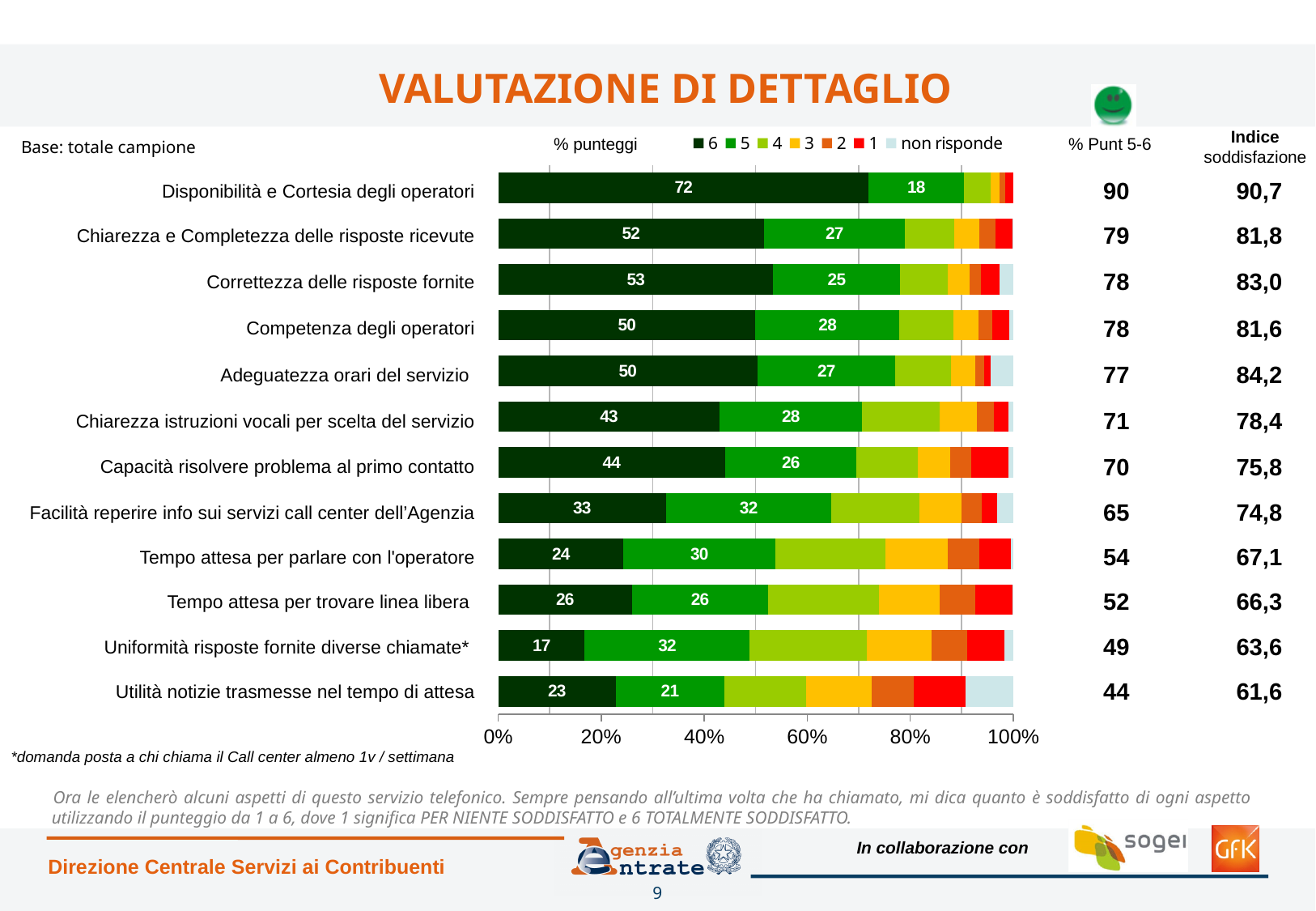
Which category has the lowest value for the "6" series? Uniformità risposte fornite diverse chiamate* Which legend entry is represented by the light blue colour? non risponde Which category has the highest value for the "6" series? Disponibilità e Cortesia degli operatori What is the "Indice soddisfazione" value shown for "Utilità notizie trasmesse nel tempo di attesa"? 61,6 How many series does the legend list? 7 What is the difference between the "6" and "5" values for "Disponibilità e Cortesia degli operatori"? 54 What kind of chart is shown on the slide? Stacked bar chart Which has a larger "5" value: "Facilità reperire info sui servizi call center dell'Agenzia" or "Capacità risolvere problema al primo contatto"? Facilità reperire info sui servizi call center dell'Agenzia What is the combined value of the "6" and "5" segments for "Competenza degli operatori"? 78 What is the value of the "5" segment for "Tempo attesa per parlare con l'operatore"? 30 How many categories are shown in the chart? 12 What is the value of the "6" segment for "Disponibilità e Cortesia degli operatori"? 72